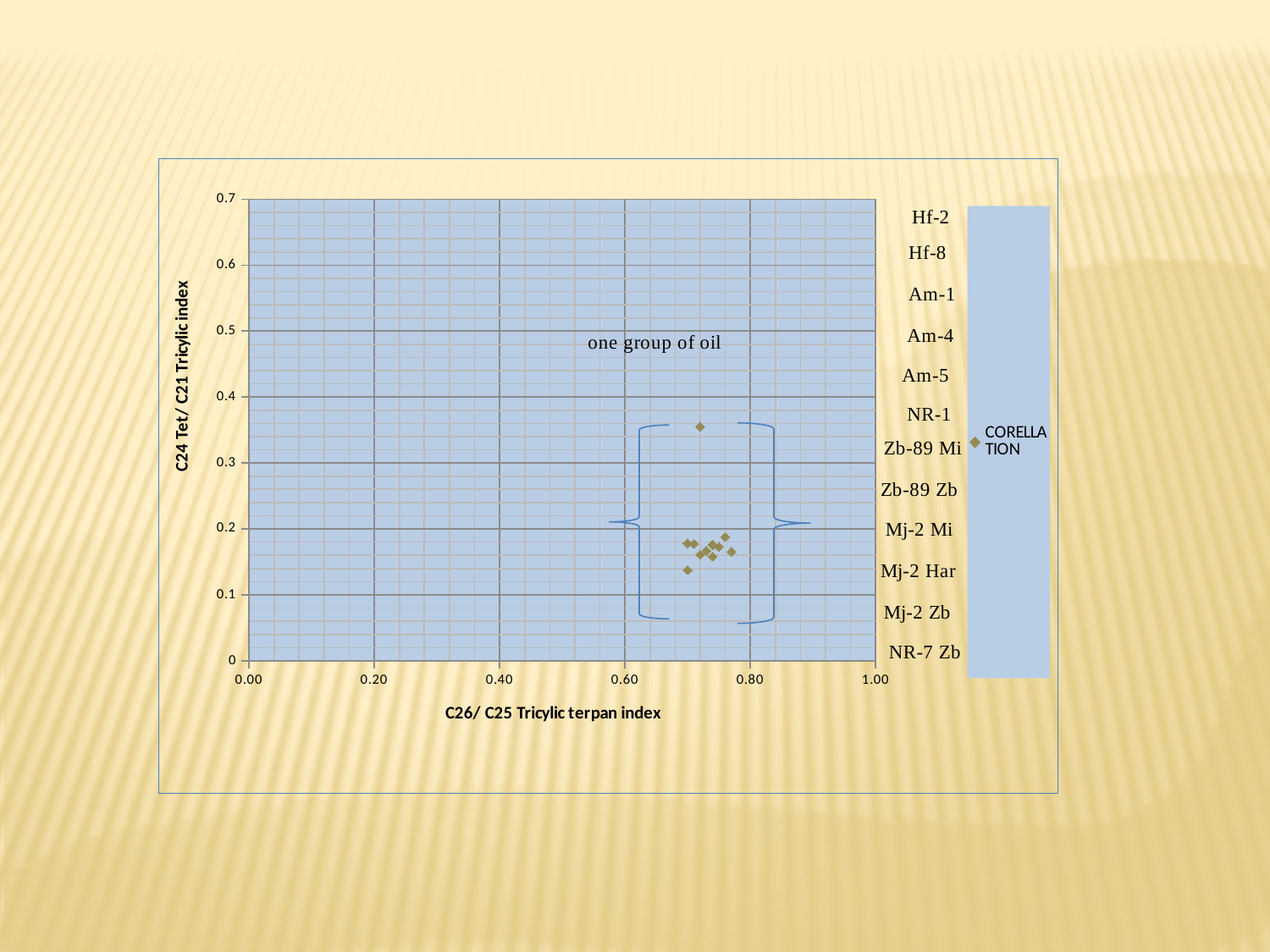
What kind of chart is shown on the slide? scatter chart What is the name of the series shown in the chart legend? CORELLATION Is the C26/C25 Tricylic terpan index value of the plotted points greater or less than 0.60? greater What text annotation is written inside the plot area of the chart? one group of oil Is the C24 Tet/C21 Tricylic index value of the lowest plotted point greater or less than 0.1? greater Is the C24 Tet/C21 Tricylic index value of the highest plotted point greater or less than 0.3? greater How many sample names are listed to the right of the plot area (from Hf-2 to NR-7 Zb)? 12 How many series does the chart legend list? 1